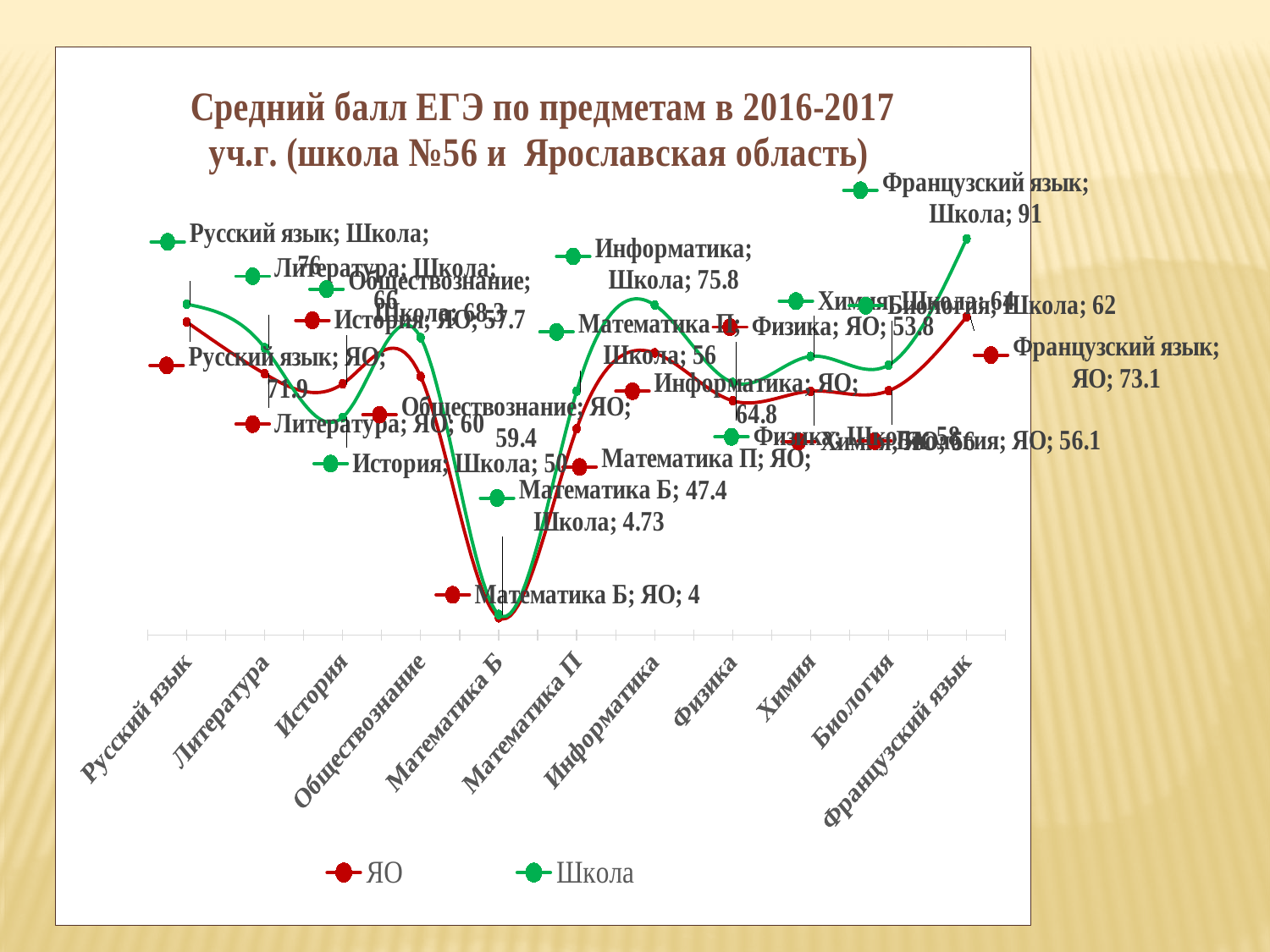
How many series does the legend list? 2 What type of chart is shown on the slide? line chart Which subject has the lowest value in the ЯО series? Математика Б Which is larger for Обществознание: the Школа value or the ЯО value? Школа Which subject has the highest value in the Школа series? Французский язык What is the value for Русский язык in the ЯО series? 71.9 Which series is drawn in red? ЯО What is the value for Русский язык in the Школа series? 76 What is the difference between the Школа and ЯО values for Информатика? 11 What is the value for Информатика in the Школа series? 75.8 What is the value for Французский язык in the ЯО series? 73.1 How many subjects are shown along the x axis? 11